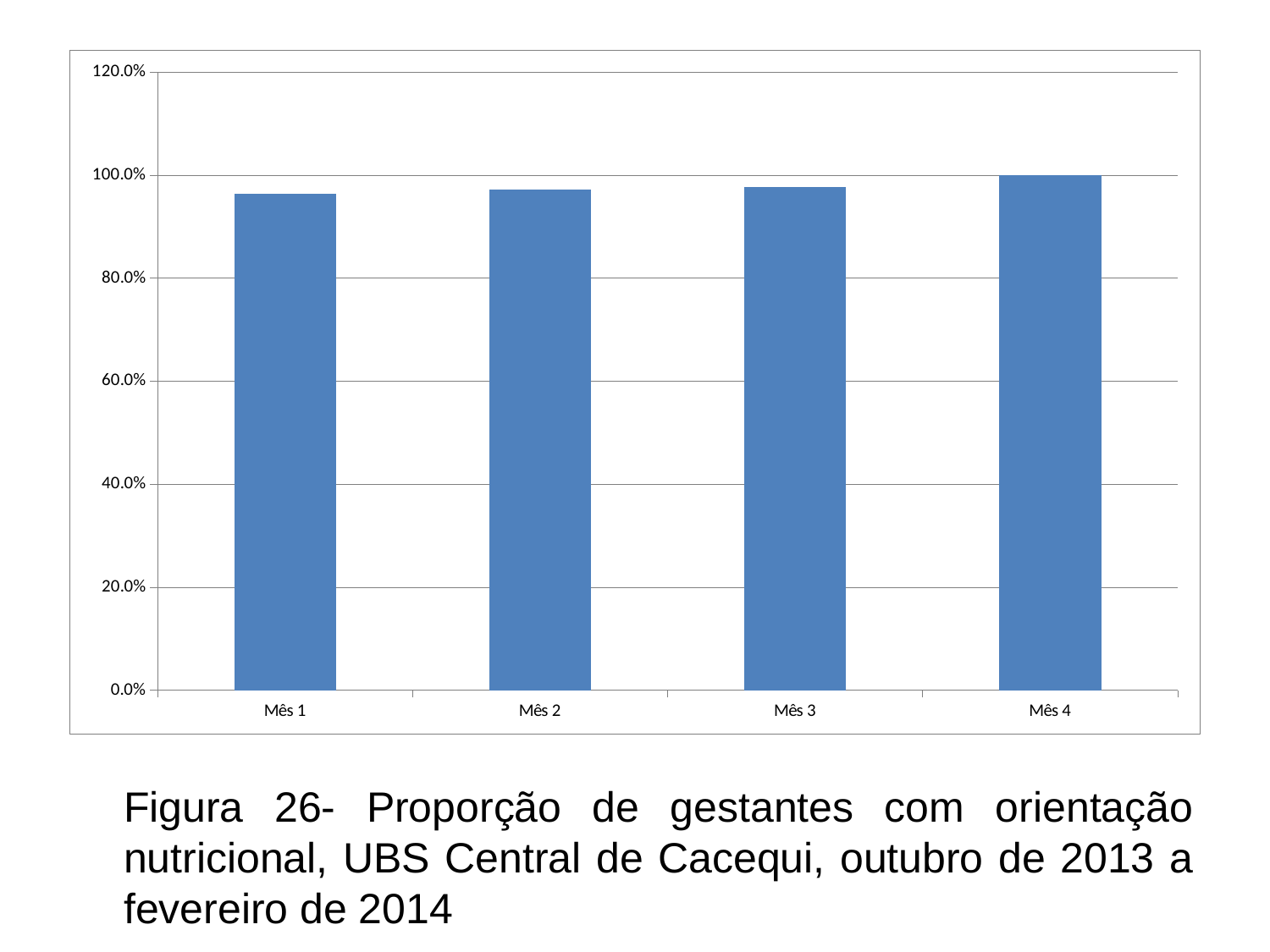
Which is larger, the value for Mês 1 or the value for Mês 4? Mês 4 Do the values rise or fall from Mês 1 to Mês 4? rise Is the value for Mês 2 greater or less than 100.0%? less What is the value for Mês 4? 100.0% Is the value for Mês 1 greater or less than 100.0%? less Is the value for Mês 1 greater or less than 80.0%? greater Which month has the highest value on the chart? Mês 4 What is the highest value shown on the vertical axis? 120.0% How many categories (months) are plotted on the chart? 4 What kind of chart is shown on the slide? bar chart According to the caption, which figure number is this chart? Figura 26